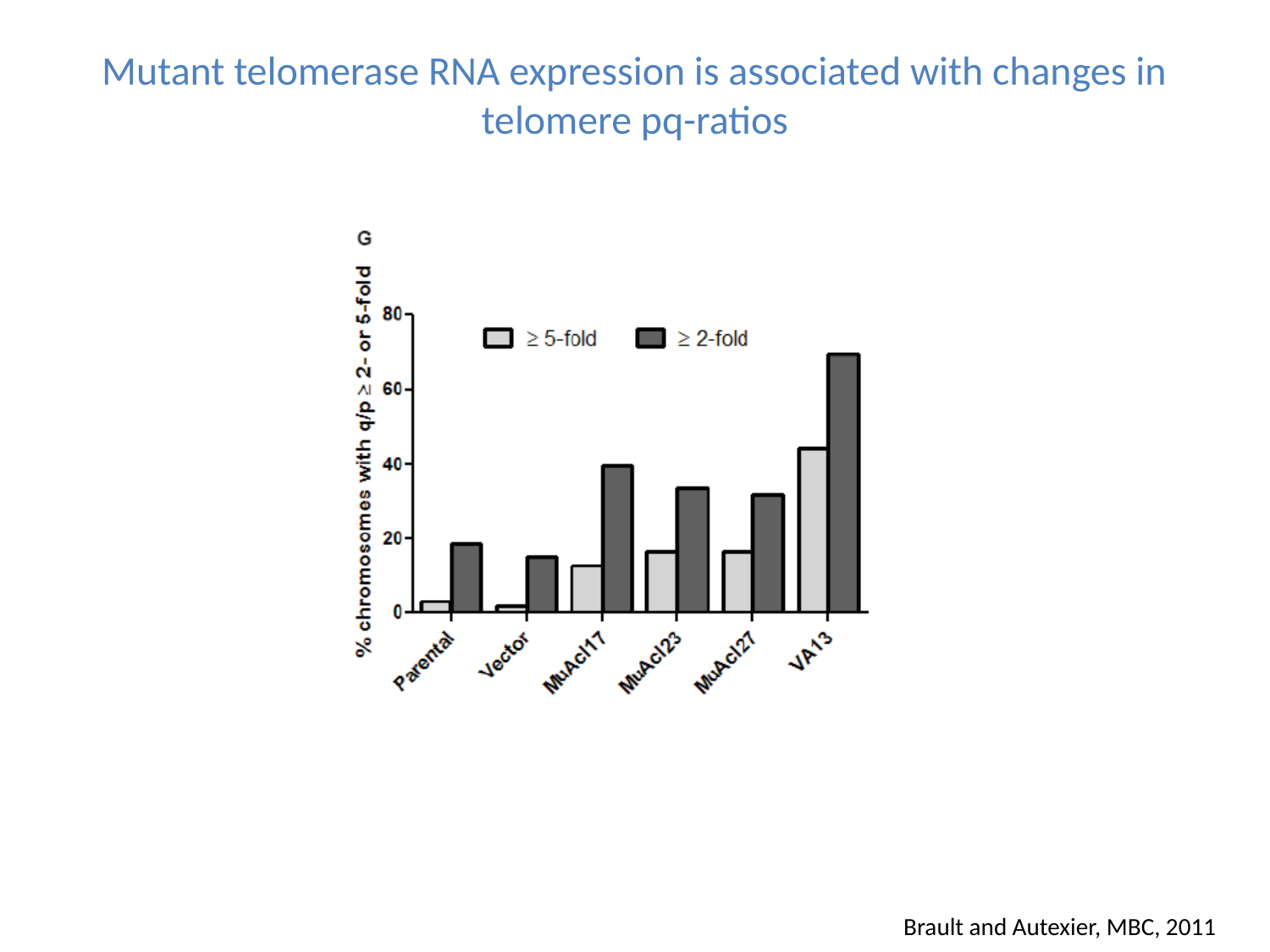
Which is larger, the ≥ 2-fold value for MuAcl17 or the ≥ 2-fold value for Parental? MuAcl17 What are the two entries in the chart's legend? ≥ 5-fold and ≥ 2-fold Which category has the highest value for the ≥ 5-fold series? VA13 Which category has the lowest value for the ≥ 2-fold series? Vector What kind of chart is shown on the slide? bar chart Is the ≥ 2-fold value for MuAcl23 greater or less than 20? greater Which category has the lowest value for the ≥ 5-fold series? Vector Which category has the highest value for the ≥ 2-fold series? VA13 How many series does the legend list? 2 Is the ≥ 5-fold value for Parental greater or less than 20? less Is the ≥ 2-fold value for VA13 greater or less than 60? greater How many categories are shown along the x axis? 6